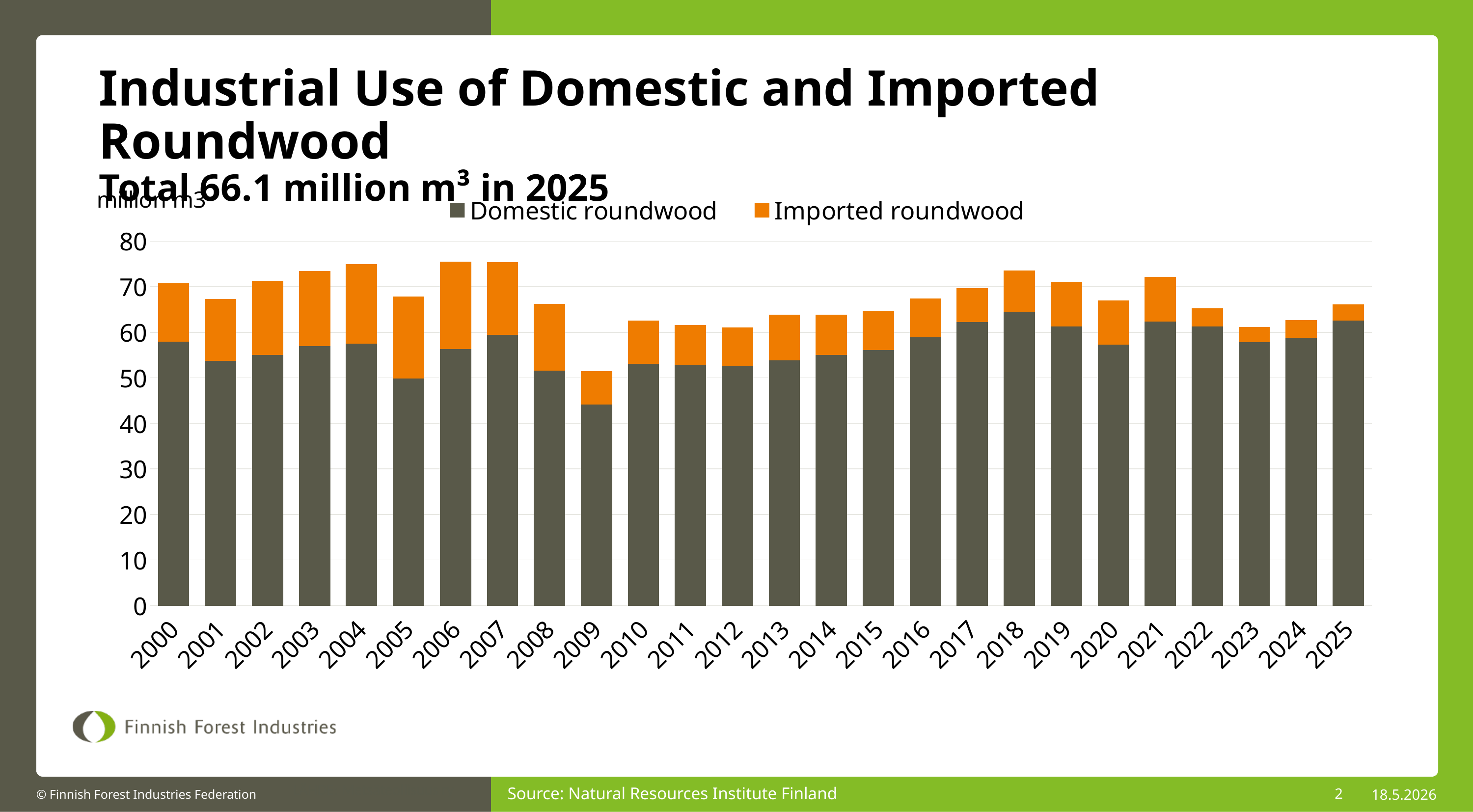
How many series does the legend list? 2 Which year has the lowest total industrial use of roundwood? 2009 Is the Domestic roundwood value for 2009 greater or less than 50? less Is the Domestic roundwood value for 2018 greater or less than 60? greater Is the total bar for 2009 greater or less than 60? less How many years are shown along the x axis of the chart? 26 Which year has the lowest value for Domestic roundwood? 2009 What was the total industrial use of roundwood in 2025, according to the slide? 66.1 million m³ What kind of chart is shown on the slide? Stacked bar chart Which colour represents Imported roundwood in the chart? Orange Which year has the larger total bar, 2009 or 2018? 2018 Did the total industrial use of roundwood rise or fall from 2009 to 2010? rise